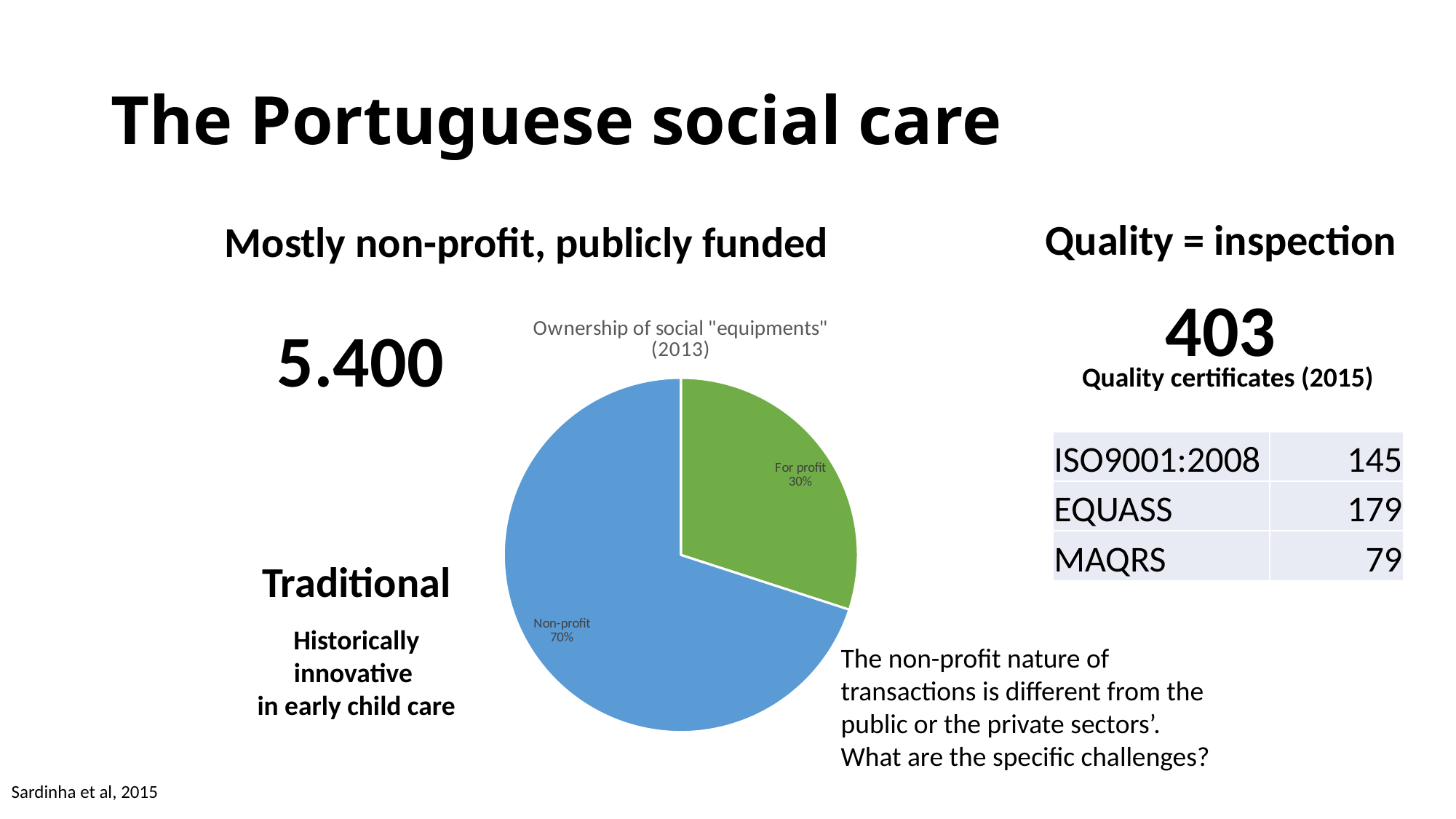
What is the title of the pie chart? Ownership of social "equipments" (2013) Which slice of the pie chart is the largest? Non-profit What share of the pie chart is For profit? 30% Is the share for Non-profit greater or less than 50%? greater What colour is the Non-profit slice of the pie chart? blue What is the difference in percentage points between the Non-profit and For profit slices? 40 What share of the pie chart is Non-profit? 70% How many slices does the pie chart have? 2 Which slice of the pie chart is the smallest? For profit Which is larger in the pie chart, Non-profit or For profit? Non-profit What kind of chart is shown on the slide? pie chart